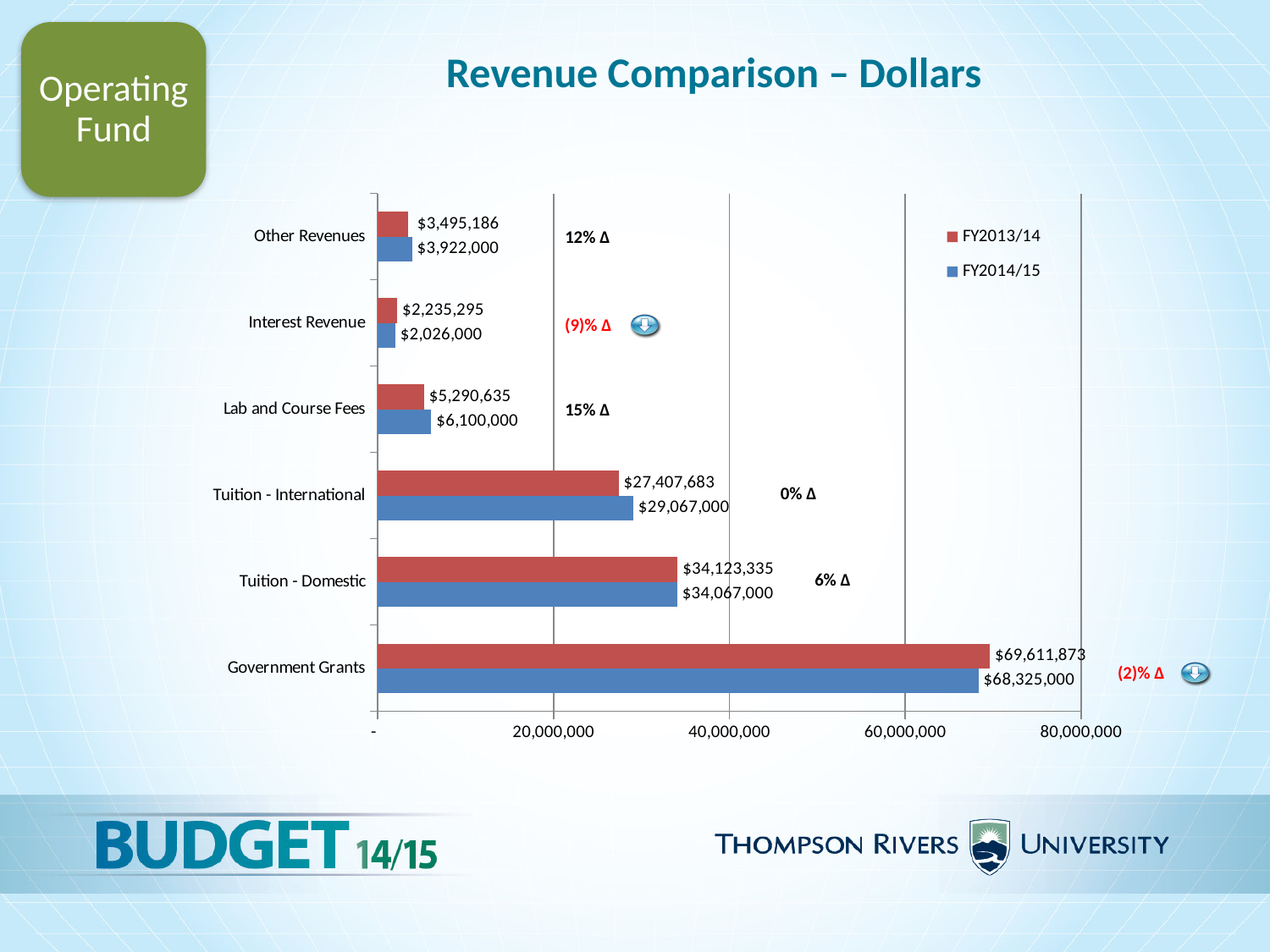
What is the FY2013/14 value for Tuition - International? $27,407,683 How many series does the legend list? 2 Which category has the lowest FY2014/15 value? Interest Revenue What is the FY2013/14 value for Interest Revenue? $2,235,295 What is the FY2014/15 value for Lab and Course Fees? $6,100,000 What is the FY2014/15 value for Government Grants? $68,325,000 Is the FY2014/15 value for Tuition - International greater or less than 20,000,000? greater What is the difference between the FY2013/14 and FY2014/15 values for Government Grants? $1,286,873 Which category has the highest FY2013/14 value? Government Grants Which is larger for Other Revenues: the FY2013/14 value or the FY2014/15 value? FY2014/15 What kind of chart is shown on the slide? bar chart How many revenue categories are shown on the chart? 6